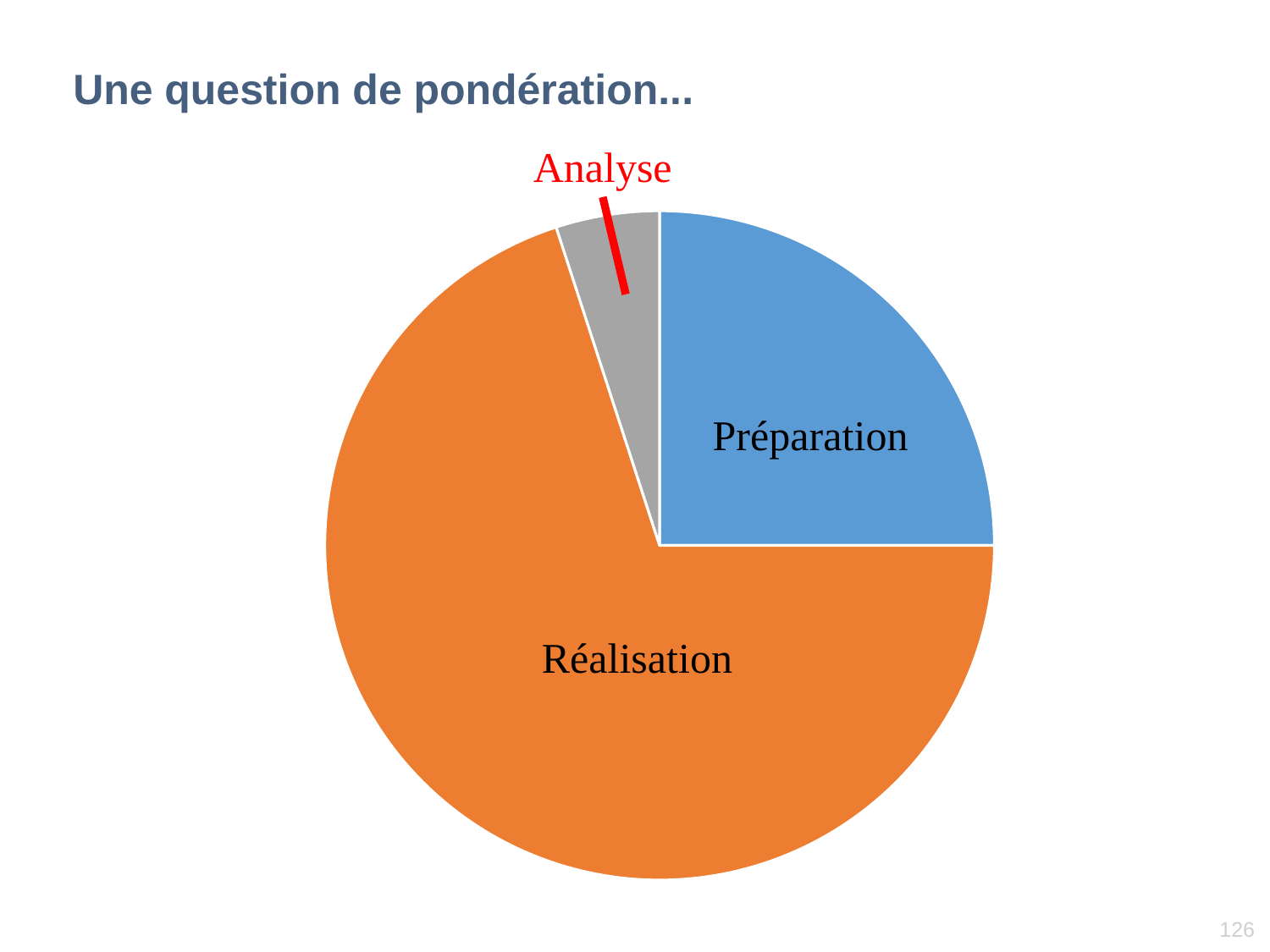
How many slices does the pie chart have? 3 Which slice of the pie chart is the largest? Réalisation What colour is the Réalisation slice of the pie chart? Orange Which slice is larger, Réalisation or Préparation? Réalisation What is the title of the slide containing the pie chart? Une question de pondération... Which slice is larger, Préparation or Analyse? Préparation Which slice is smaller, Analyse or Réalisation? Analyse What kind of chart is shown on the slide? Pie chart Which slice of the pie chart is the smallest? Analyse